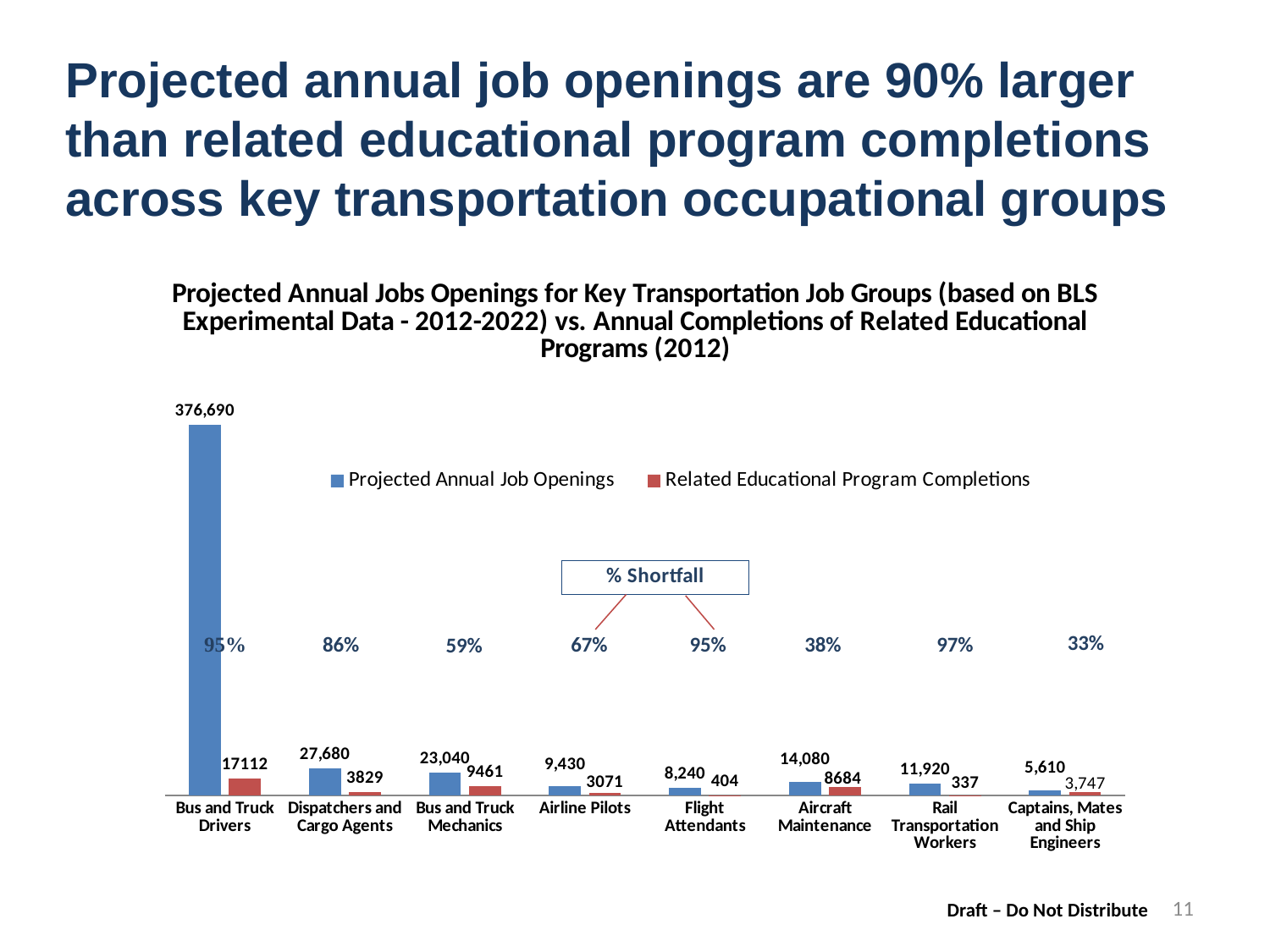
What is the Projected Annual Job Openings value for Bus and Truck Drivers? 376,690 Which colour represents Related Educational Program Completions in the chart? Red Which category has the highest Projected Annual Job Openings? Bus and Truck Drivers What is the % Shortfall shown for Bus and Truck Mechanics? 59% What is the Projected Annual Job Openings value for Rail Transportation Workers? 11,920 How many occupational groups are shown on the x axis? 8 What is the Related Educational Program Completions value for Aircraft Maintenance? 8684 What is the difference between Projected Annual Job Openings and Related Educational Program Completions for Airline Pilots? 6,359 How many series does the legend list? 2 Which category has the lowest Related Educational Program Completions? Rail Transportation Workers Which is larger: Projected Annual Job Openings for Dispatchers and Cargo Agents or for Bus and Truck Mechanics? Dispatchers and Cargo Agents What kind of chart is shown on the slide? Bar chart